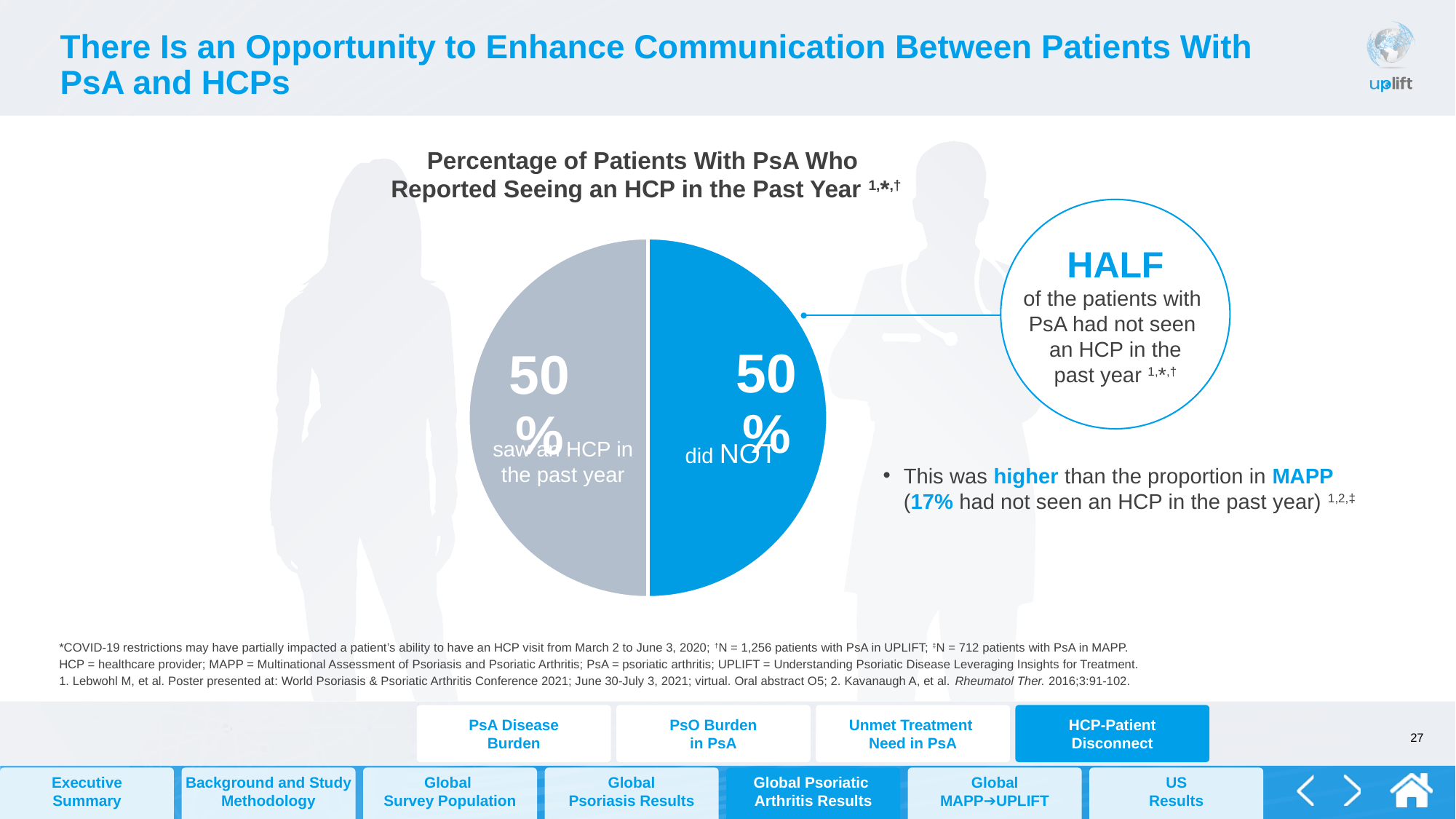
How many slices does the pie chart have? 2 What percentage of patients with PsA did NOT see an HCP in the past year? 50% Is the value for the 'did NOT' slice greater or less than 25%? greater What percentage of patients with PsA saw an HCP in the past year? 50% What share of the pie is taken by the slice labelled 'saw an HCP in the past year'? 50% What is the title of the chart? Percentage of Patients With PsA Who Reported Seeing an HCP in the Past Year What type of chart is shown on the slide? pie chart What is the difference between the 'saw an HCP in the past year' slice and the 'did NOT' slice? 0% What colour is the slice representing patients who did NOT see an HCP in the past year? blue What share of the pie is taken by the slice labelled 'did NOT'? 50% What do the two slices of the pie chart add up to? 100%